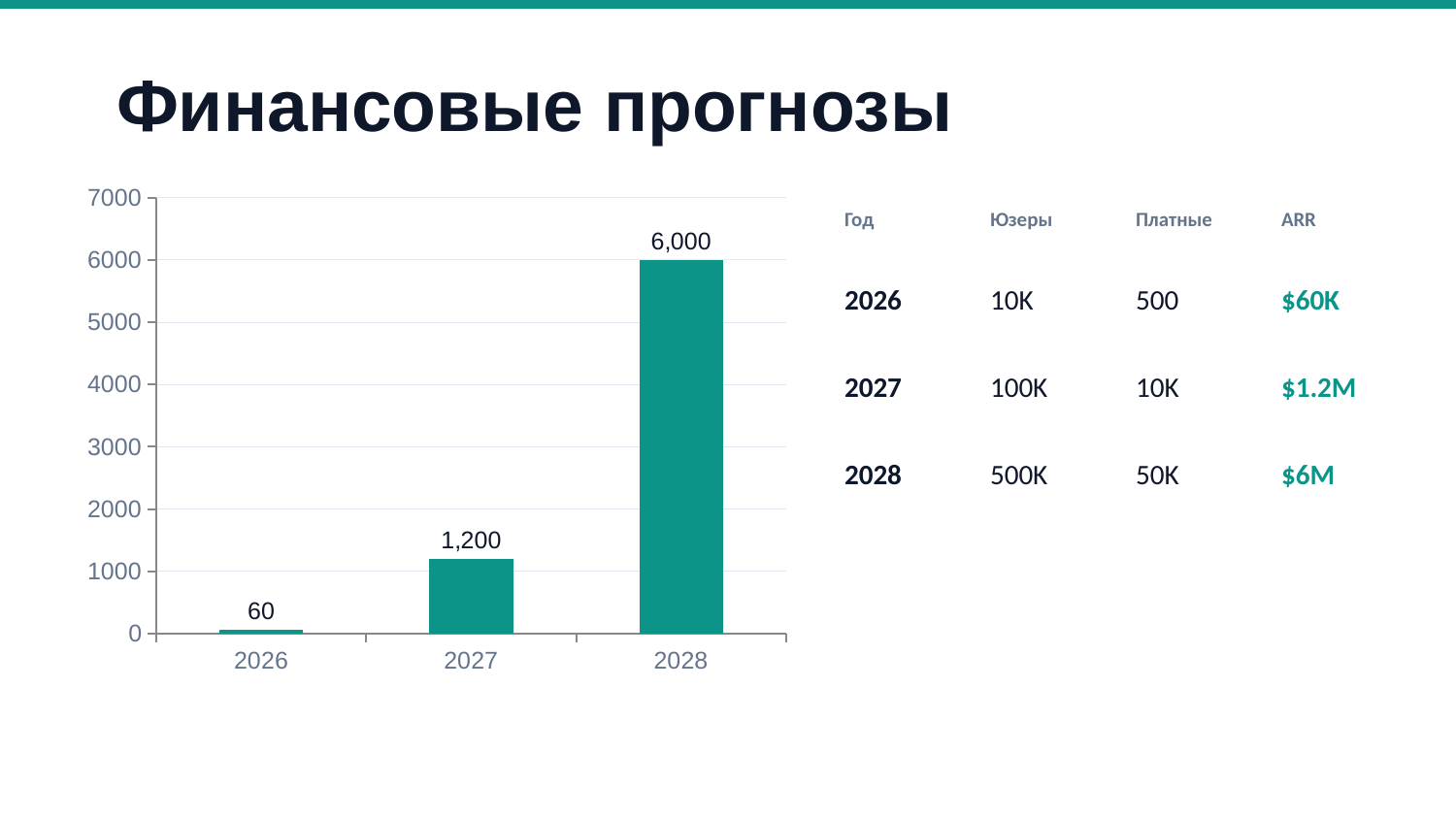
What is the value of the bar for 2027? 1,200 Do the values rise or fall from 2026 to 2028? rise Is the value for 2028 greater or less than 5000? greater Which is larger, the value for 2027 or the value for 2026? 2027 How many bars are shown in the chart? 3 What is the difference between the values for 2027 and 2026? 1,140 What kind of chart is shown on the slide? bar chart Which year has the highest bar? 2028 What is the value of the bar for 2028? 6,000 What is the difference between the values for 2028 and 2027? 4,800 What is the value of the bar for 2026? 60 Which year has the lowest bar? 2026